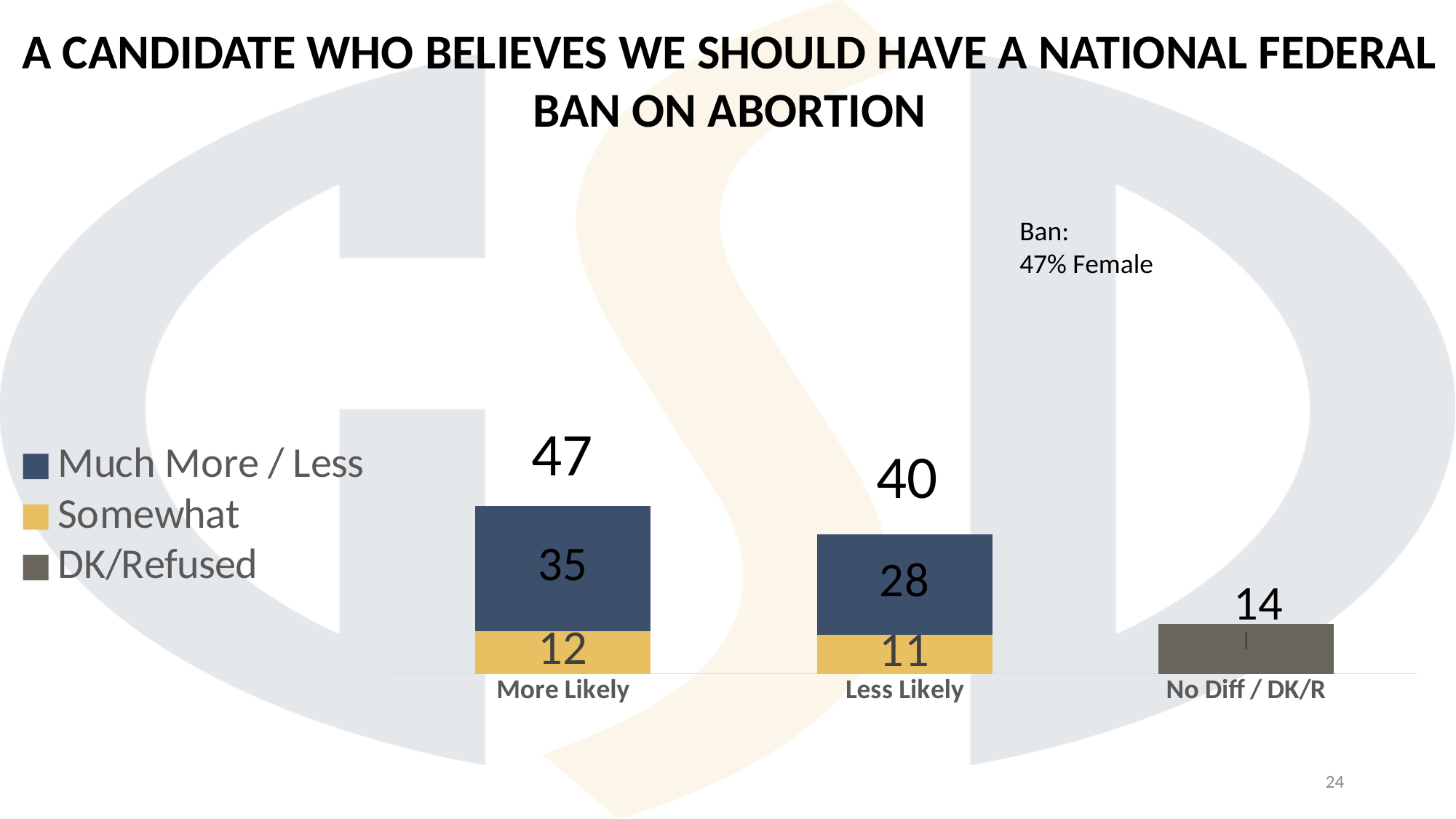
Which category has the lowest total? No Diff / DK/R Which is larger: the 'Much More / Less' value for More Likely or for Less Likely? More Likely What is the total shown above the Less Likely bar? 40 How many series does the legend list? 3 What is the difference between the More Likely total and the Less Likely total? 7 What is the value shown for No Diff / DK/R? 14 Which category has the highest total? More Likely What kind of chart is shown on the slide? Stacked bar chart What is the 'Much More / Less' value for the More Likely bar? 35 How many categories are shown on the x axis? 3 What is the 'Somewhat' value for the Less Likely bar? 11 What is the total shown above the More Likely bar? 47